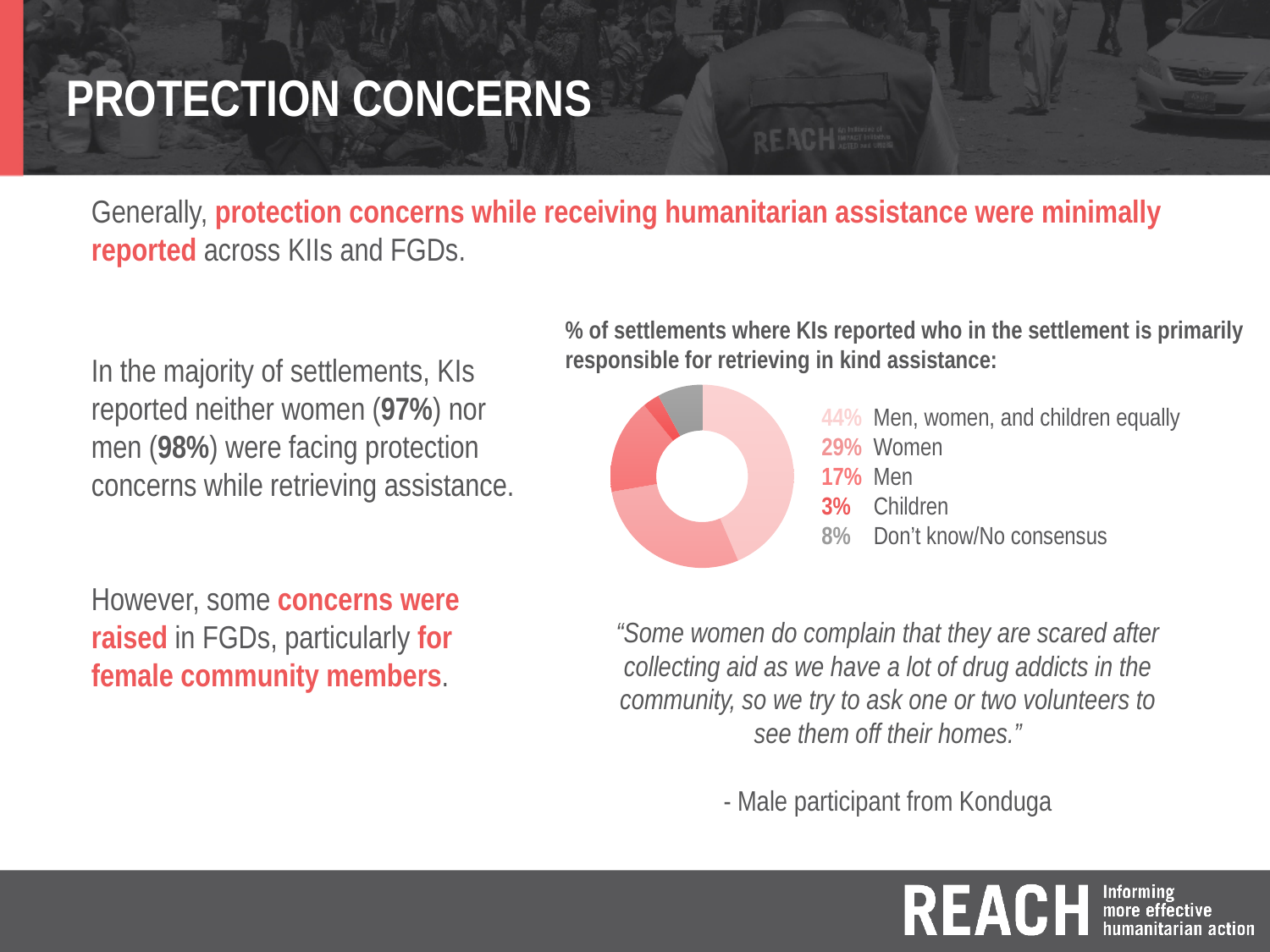
What percentage of settlements reported that men are primarily responsible for retrieving in kind assistance? 17% What percentage of settlements fall under 'Don't know/No consensus' in the chart? 8% Which category has the largest share in the chart? Men, women, and children equally What percentage of settlements reported that men, women, and children equally are primarily responsible for retrieving in kind assistance? 44% What kind of chart is shown on the slide? Pie chart (donut) What percentage of settlements reported that women are primarily responsible for retrieving in kind assistance? 29% How many categories are shown in the chart? 5 Which is larger in the chart: the share for 'Women' or the share for 'Men'? Women What is the title of the chart on the slide? % of settlements where KIs reported who in the settlement is primarily responsible for retrieving in kind assistance Which category has the smallest share in the chart? Children What is the difference in percentage points between the 'Women' and 'Men' categories in the chart? 12% What percentage of settlements reported that children are primarily responsible for retrieving in kind assistance? 3%